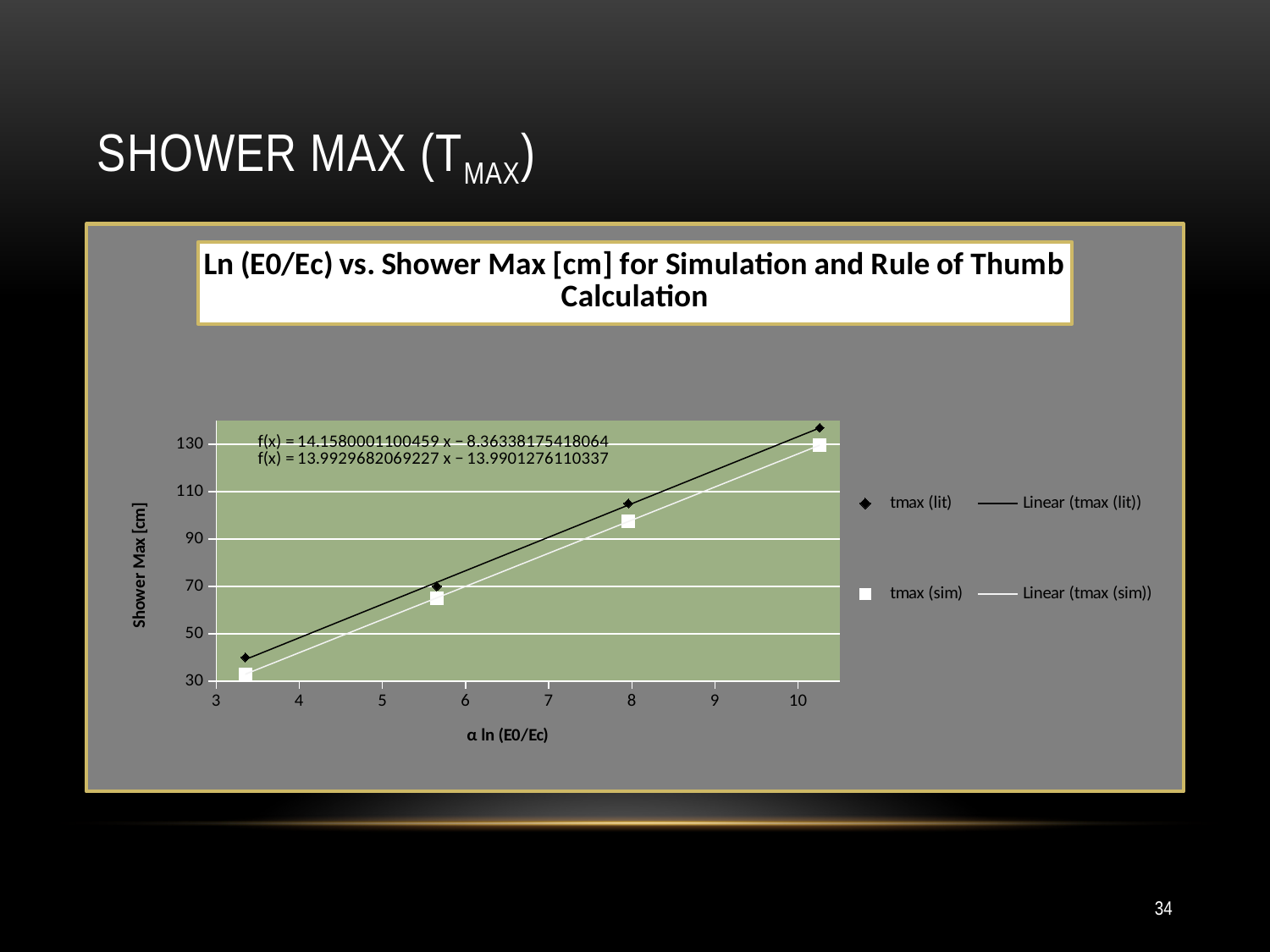
Do the tmax (lit) values rise or fall as α ln (E0/Ec) increases? rise Do the tmax (sim) values rise or fall as α ln (E0/Ec) increases? rise What kind of chart is shown on the slide? scatter chart How many data points are plotted for the tmax (sim) series? 4 What is the label of the y axis? Shower Max [cm] Is the value of the rightmost tmax (lit) point greater or less than 130? greater Is the value of the leftmost tmax (sim) point greater or less than 50? less How many data points are plotted for the tmax (lit) series? 4 What is the title of the chart? Ln (E0/Ec) vs. Shower Max [cm] for Simulation and Rule of Thumb Calculation How many entries does the chart legend list? 4 Is the value of the third tmax (lit) point (near α ln (E0/Ec) = 8) greater or less than 90? greater At the rightmost data points, which series has the larger Shower Max value, tmax (lit) or tmax (sim)? tmax (lit)